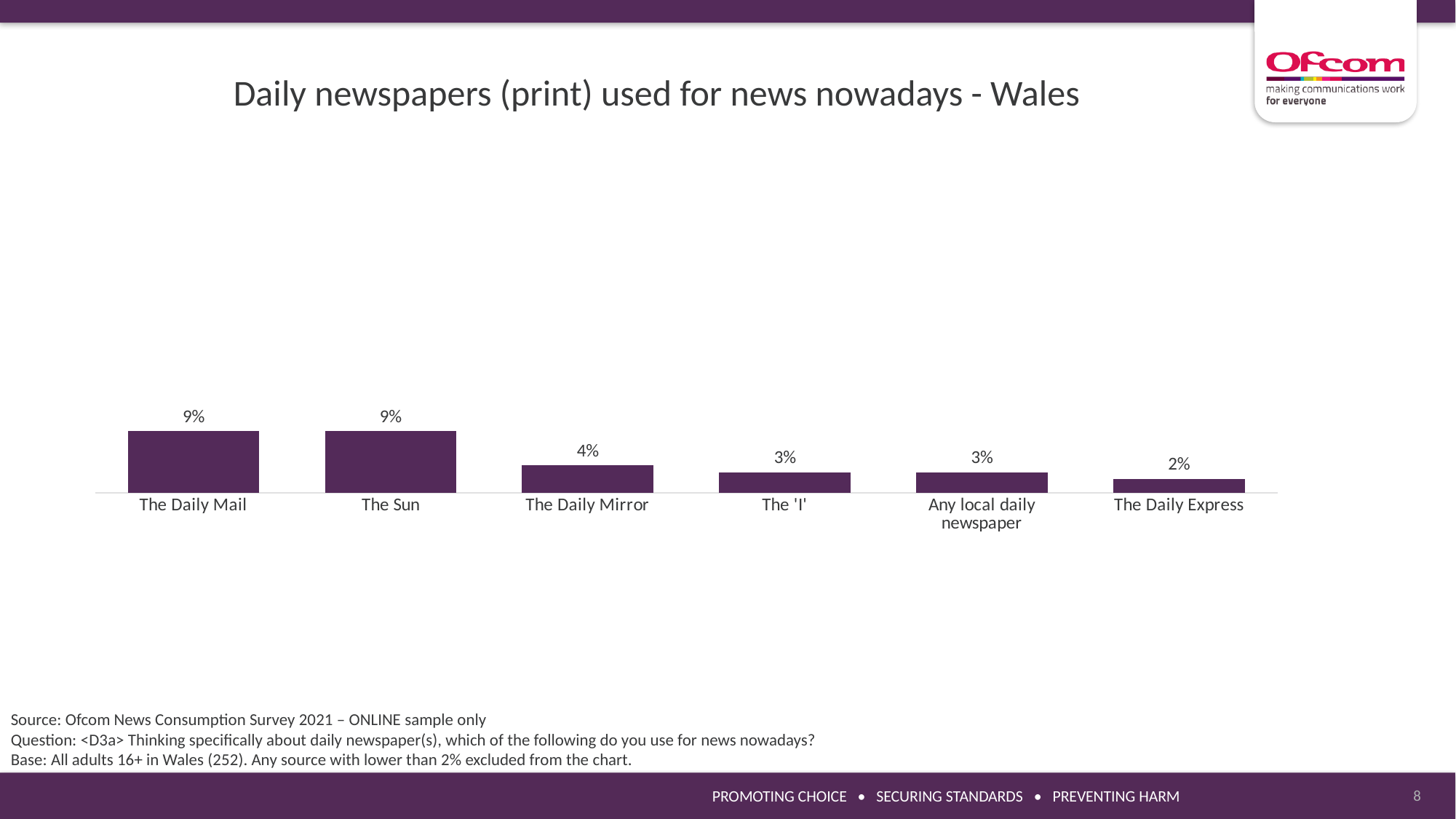
What is the difference between the values for The Sun and The Daily Mirror? 5% What is the value for The Daily Mail? 9% Which is larger, the value for The Daily Mail or the value for The 'I'? The Daily Mail What is the value for Any local daily newspaper? 3% What is the value for The 'I'? 3% What is the value for The Daily Express? 2% What is the value for The Daily Mirror? 4% How many categories are shown in the chart? 6 What is the difference between the values for The Daily Mirror and The Daily Express? 2% What is the title of the chart? Daily newspapers (print) used for news nowadays - Wales What kind of chart is shown on the slide? Bar chart Which category has the lowest value? The Daily Express